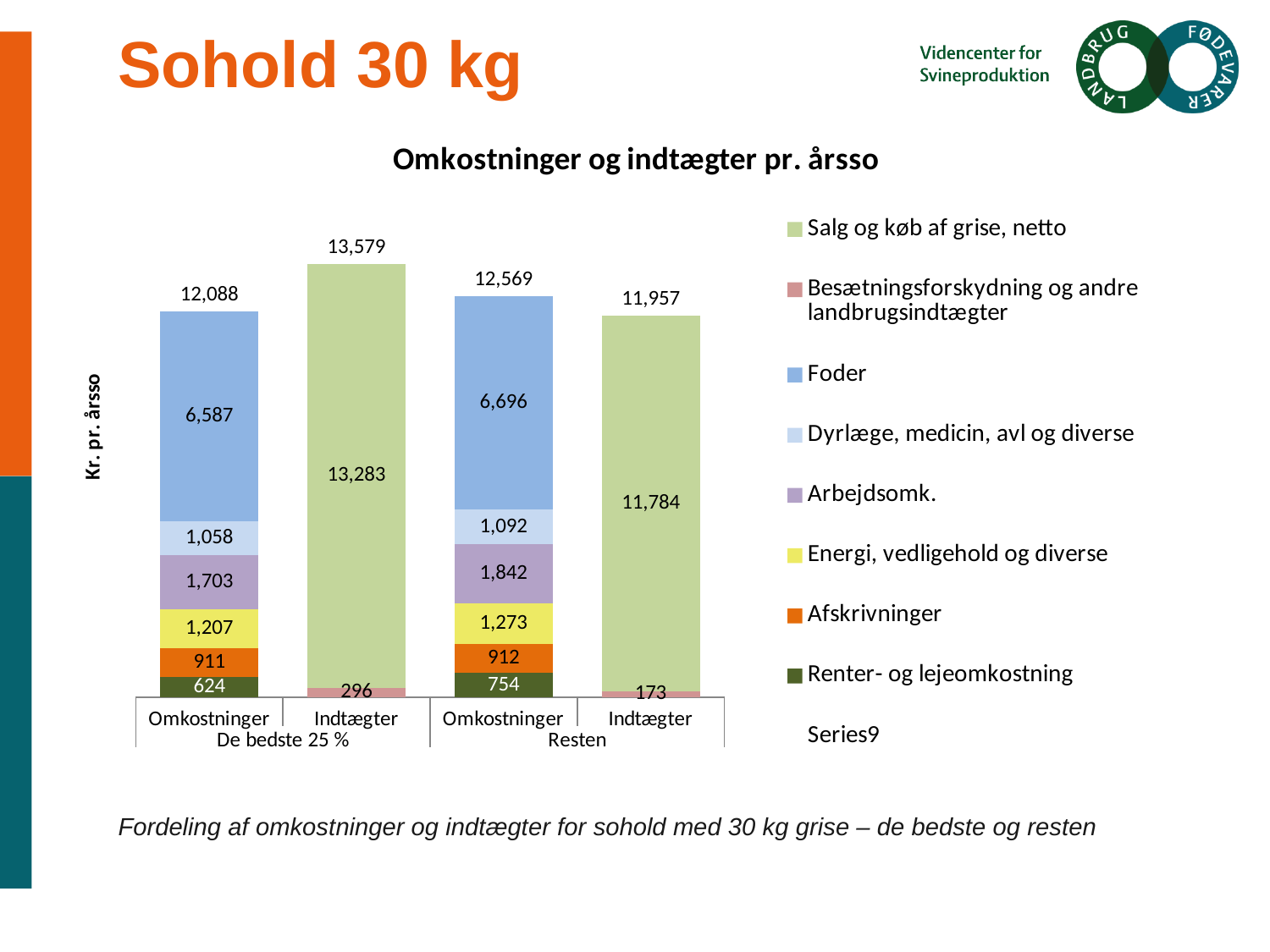
Which bar has the lowest total value? Indtægter, Resten What is the total value shown above the Indtægter bar for De bedste 25 %? 13,579 What type of chart is shown on the slide? Stacked bar chart What is the Salg og køb af grise, netto value in the Indtægter bar for De bedste 25 %? 13,283 What is the Renter- og lejeomkostning value in the Omkostninger bar for Resten? 754 What is the Foder value in the Omkostninger bar for Resten? 6,696 How many entries does the legend list? 9 What is the Arbejdsomk. value in the Omkostninger bar for De bedste 25 %? 1,703 What is the difference between the Foder values for Resten and De bedste 25 % in the Omkostninger bars? 109 How many bars are plotted in the chart? 4 Which is larger: the Energi, vedligehold og diverse value for De bedste 25 % or for Resten? Resten Which bar has the highest total value? Indtægter, De bedste 25 %